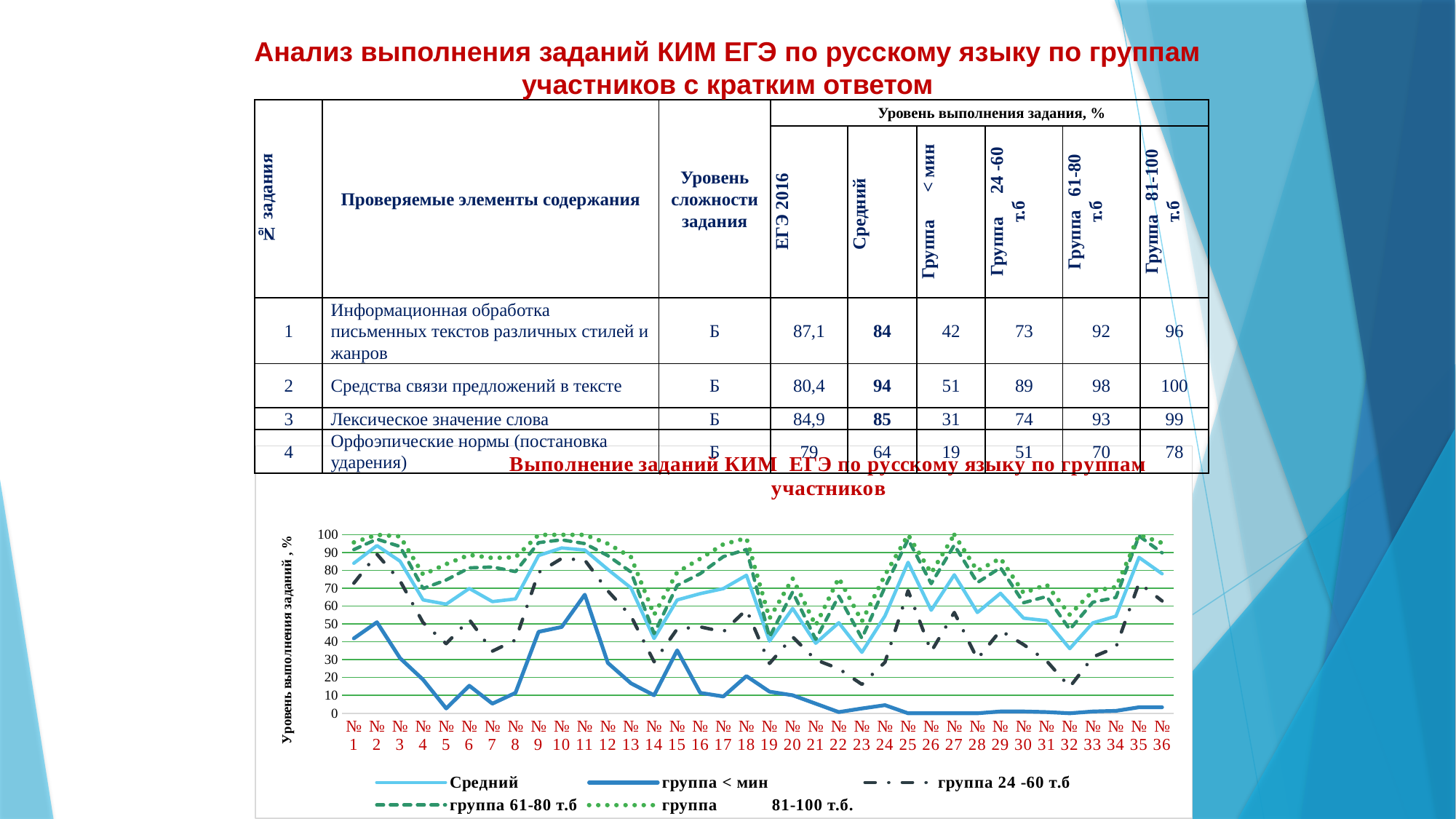
What is the title of the y axis of the line chart? Уровень выполнения заданий , % In the line chart, is the value for группа < мин at № 5 greater or less than 10? less In the line chart, is the value for группа < мин at № 36 greater or less than 10? less In the line chart, is the value for группа < мин at № 11 greater or less than 60? greater How many series does the legend of the line chart list? 5 In the line chart, which series has the lowest values across the tasks? группа < мин In the line chart, does the группа < мин series rise or fall from № 1 to № 5? fall What kind of chart is shown at the bottom of the slide? line chart How many task categories (№) are plotted along the x axis of the line chart? 36